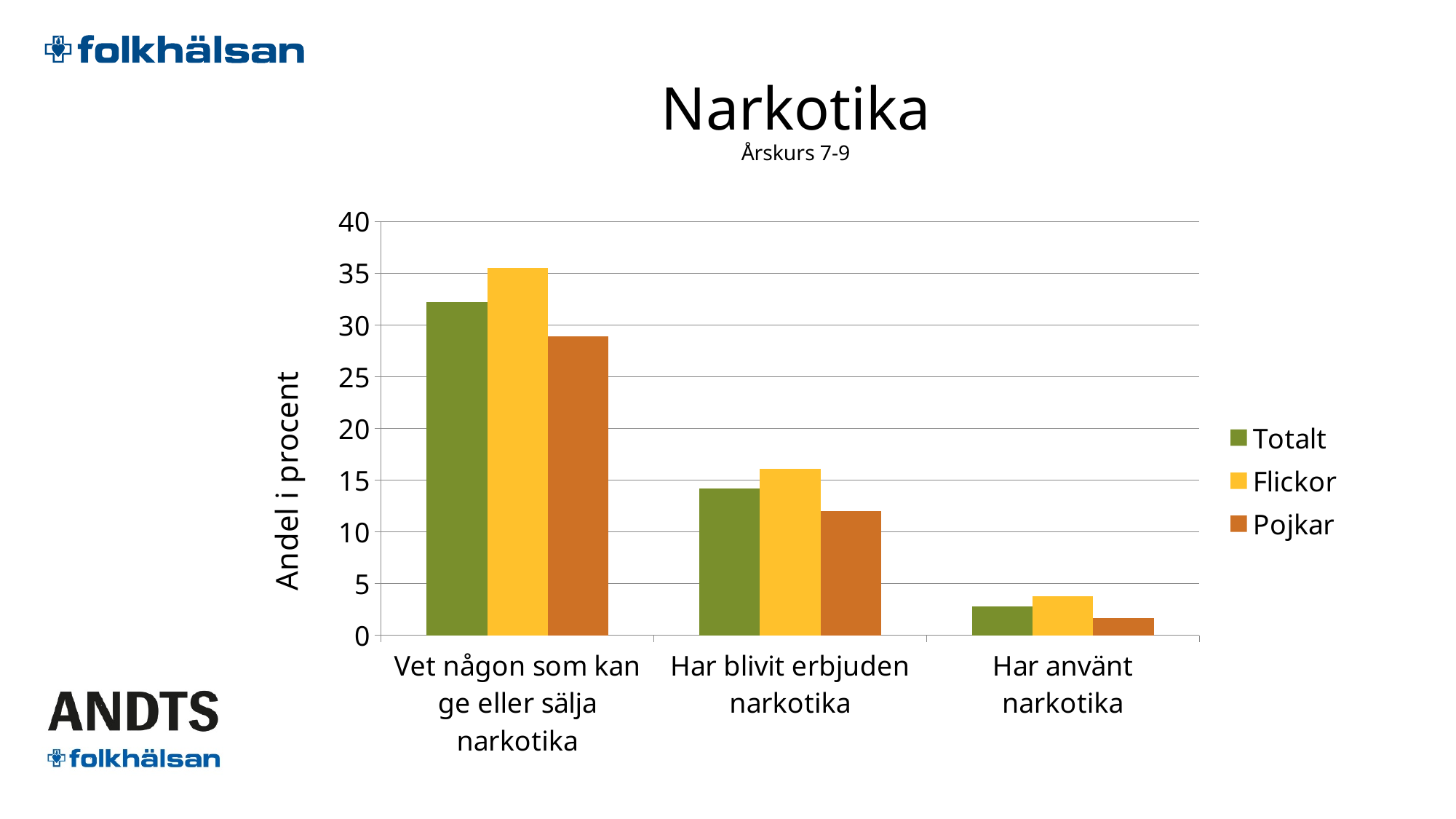
What is the label of the y axis? Andel i procent Is the Pojkar value for 'Vet någon som kan ge eller sälja narkotika' greater or less than 25? greater How many categories are shown on the x axis? 3 Which category has the highest values across all series? Vet någon som kan ge eller sälja narkotika Do the values rise or fall moving from left to right along the x axis? fall Is the Flickor value for 'Har använt narkotika' greater or less than 5? less How many series does the legend list? 3 What kind of chart is shown on the slide? bar chart For 'Har blivit erbjuden narkotika', which is larger: Flickor or Pojkar? Flickor Which category has the lowest values across all series? Har använt narkotika Is the Pojkar value for 'Har blivit erbjuden narkotika' greater or less than 10? greater